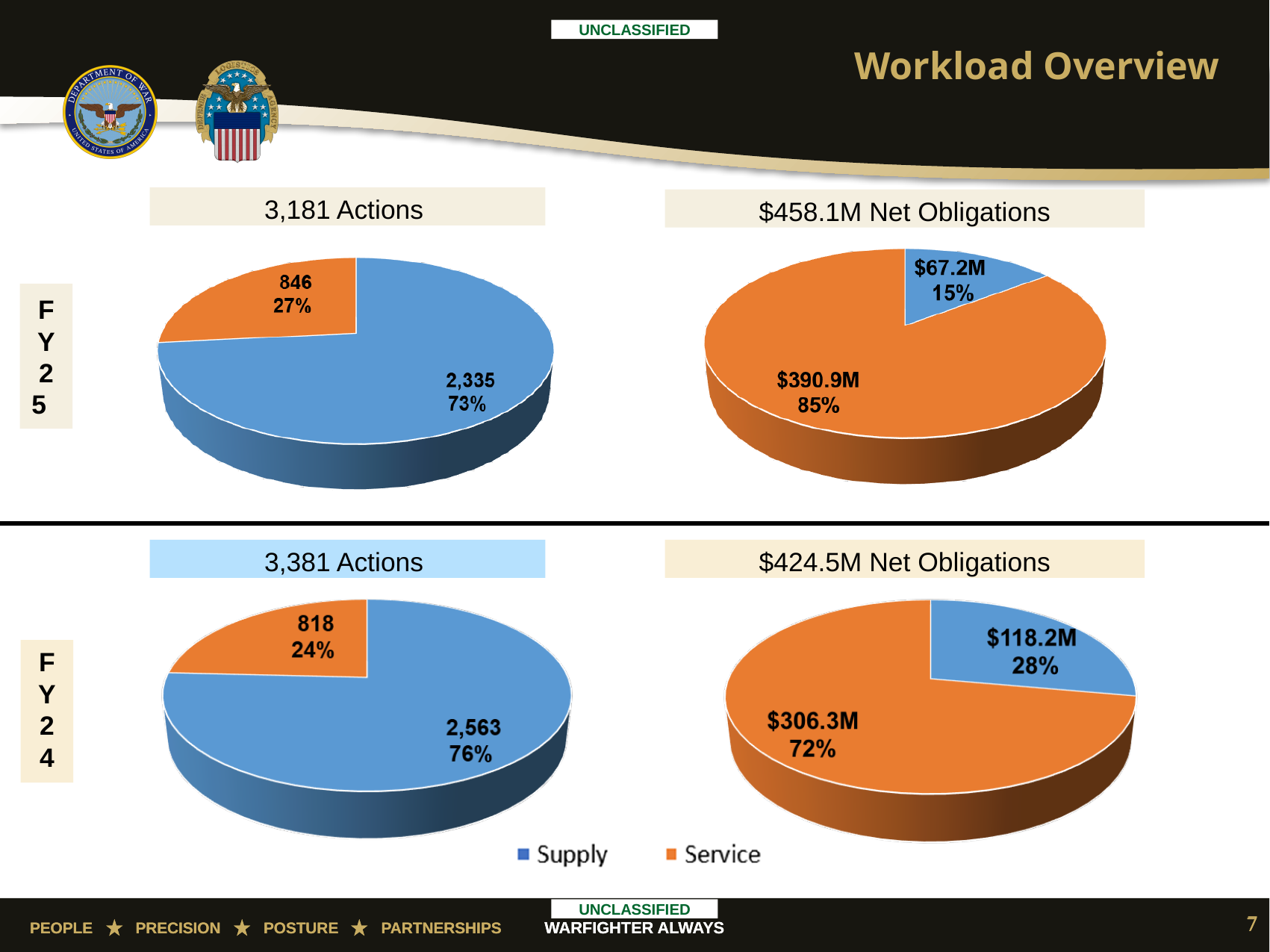
In the FY24 '$424.5M Net Obligations' pie chart, which slice is larger, Supply or Service? Service In the FY25 '3,181 Actions' pie chart, how many actions are Supply? 2,335 How many series does the legend list? 2 In the FY24 '$424.5M Net Obligations' pie chart, what is the value for Supply? $118.2M In the FY24 '3,381 Actions' pie chart, how many actions are Service? 818 In the FY25 '3,181 Actions' pie chart, what share of actions is Service? 27% In the FY25 '$458.1M Net Obligations' pie chart, what share of net obligations is Supply? 15% In the FY25 '$458.1M Net Obligations' pie chart, what is the value for Service? $390.9M How many pie charts are shown on the slide? 4 In the FY24 '3,381 Actions' pie chart, which category has the largest slice? Supply In the FY25 '3,181 Actions' pie chart, what is the difference between the Supply and Service action counts? 1,489 What type of chart is used on this slide? Pie chart